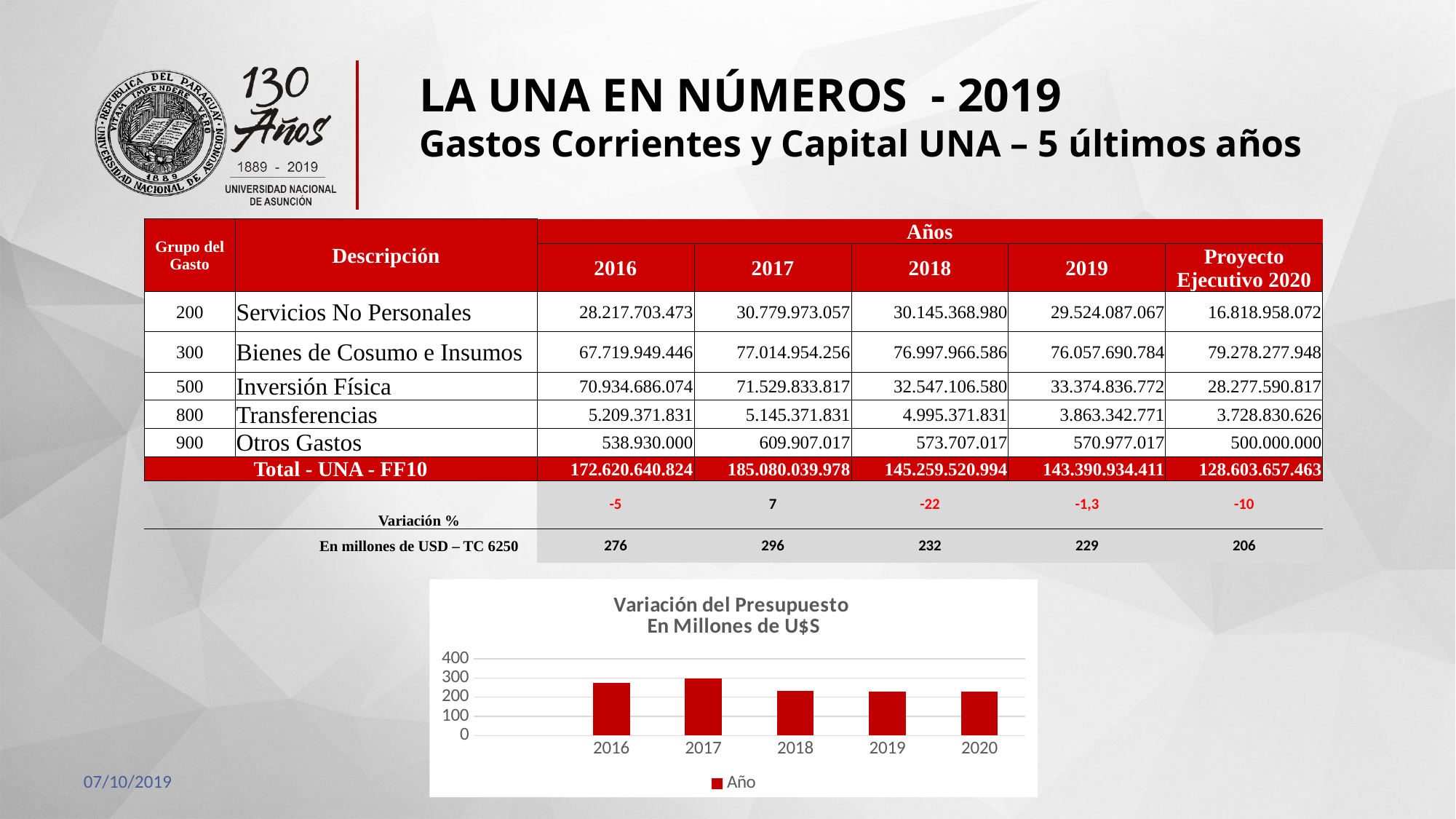
Is the bar for 2016 greater or less than 200? greater What is the title of the chart? Variación del Presupuesto En Millones de U$S Is the bar for 2018 greater or less than 300? less How many series does the chart legend list? 1 Do the bars rise or fall from 2017 to 2018? fall Which bar is taller, 2016 or 2018? 2016 What kind of chart is shown on the slide? bar chart Which year has the highest bar in the chart? 2017 Is the bar for 2019 greater or less than 200? greater What is the name of the series in the chart legend? Año How many years are shown on the x axis of the chart? 5